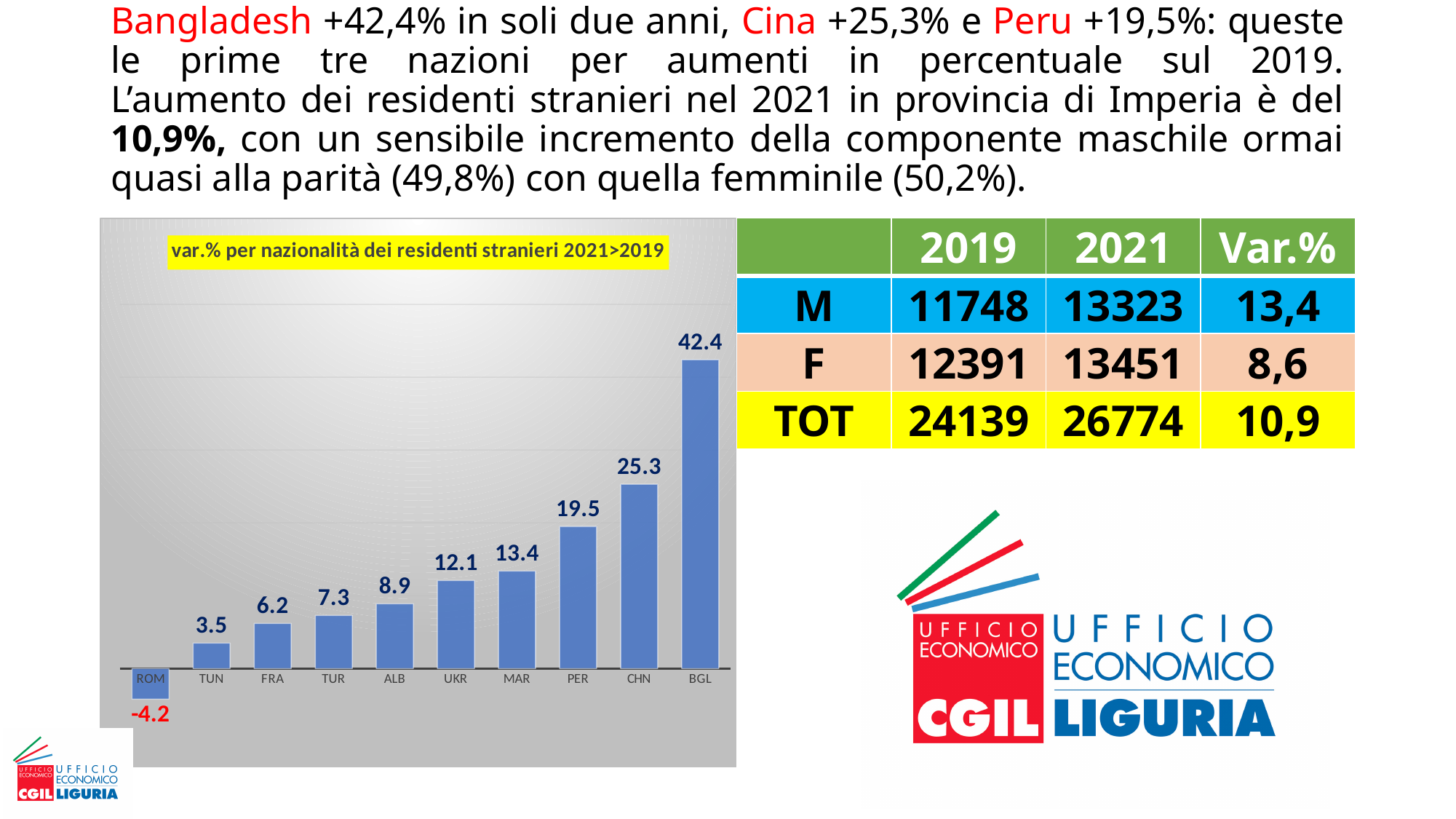
What kind of chart is shown on the slide? bar chart What is the value for UKR in the chart? 12.1 Which category has the highest value in the chart? BGL How many categories are shown in the chart? 10 What is the value for ROM in the chart? -4.2 Which is larger, the value for MAR or the value for ALB? MAR Which category has the lowest value in the chart? ROM What is the value for PER in the chart? 19.5 Do the values rise or fall from left to right along the x axis? rise What is the value for BGL in the chart? 42.4 What is the difference between the values for BGL and CHN? 17.1 What is the title of the chart? var.% per nazionalità dei residenti stranieri 2021>2019